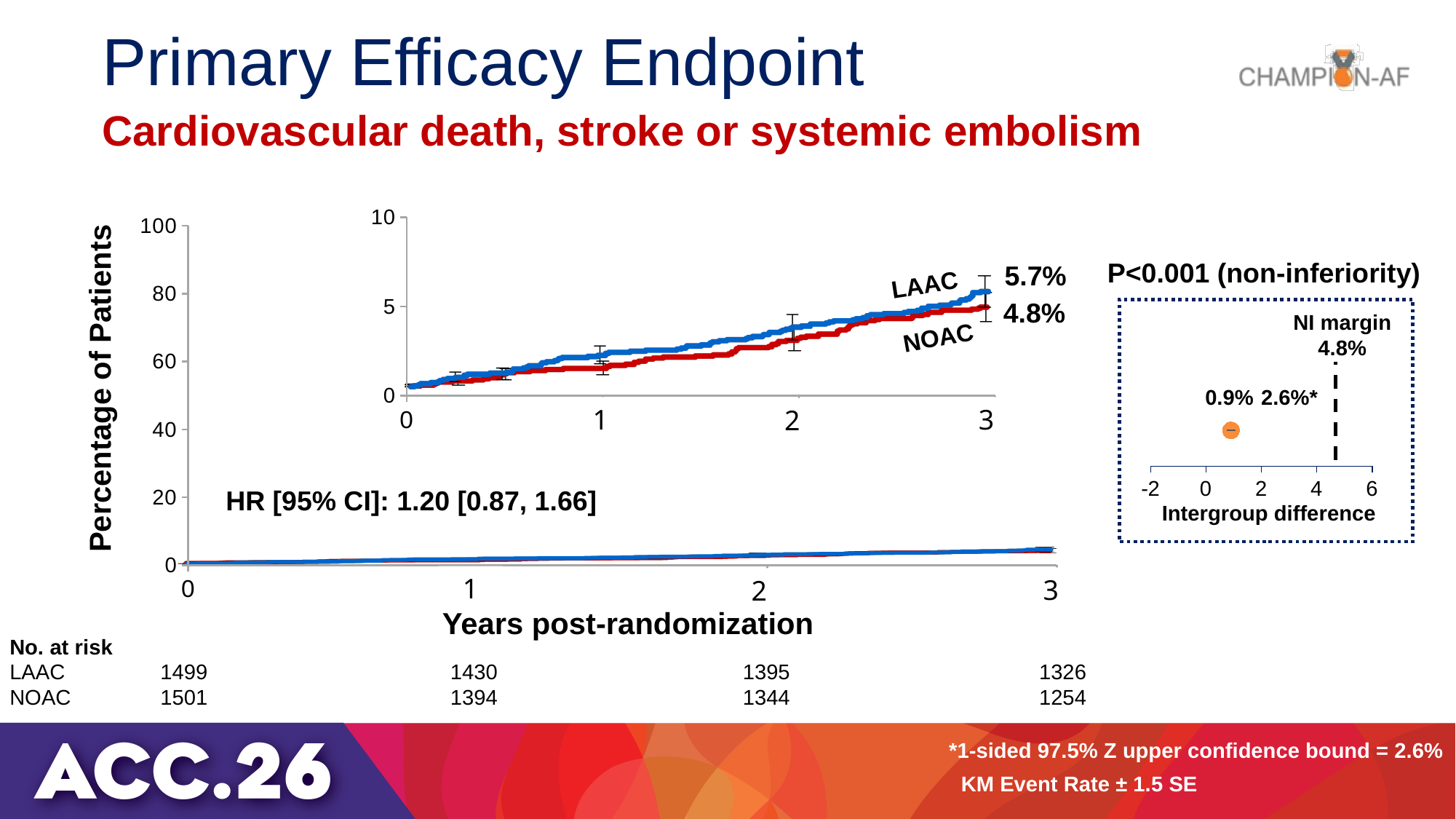
What kind of chart is the main Percentage of Patients chart? Line chart In the inset chart, do the LAAC and NOAC curves rise or fall over the years post-randomization? Rise In the Intergroup difference chart, what is the NI margin? 4.8% In the inset chart, which group has the higher event rate at 3 years, LAAC or NOAC? LAAC What is the hazard ratio shown on the main chart? 1.20 In the inset chart, what is the event rate for LAAC at 3 years? 5.7% How many groups are plotted in the inset chart? 2 In the inset chart, what is the difference between the LAAC and NOAC event rates at 3 years? 0.9% What is the x-axis label of the main chart? Years post-randomization In the Intergroup difference chart, is the plotted point estimate greater or less than 2? less In the Intergroup difference chart, what is the upper confidence bound of the intergroup difference? 2.6% In the inset chart, what is the event rate for NOAC at 3 years? 4.8%